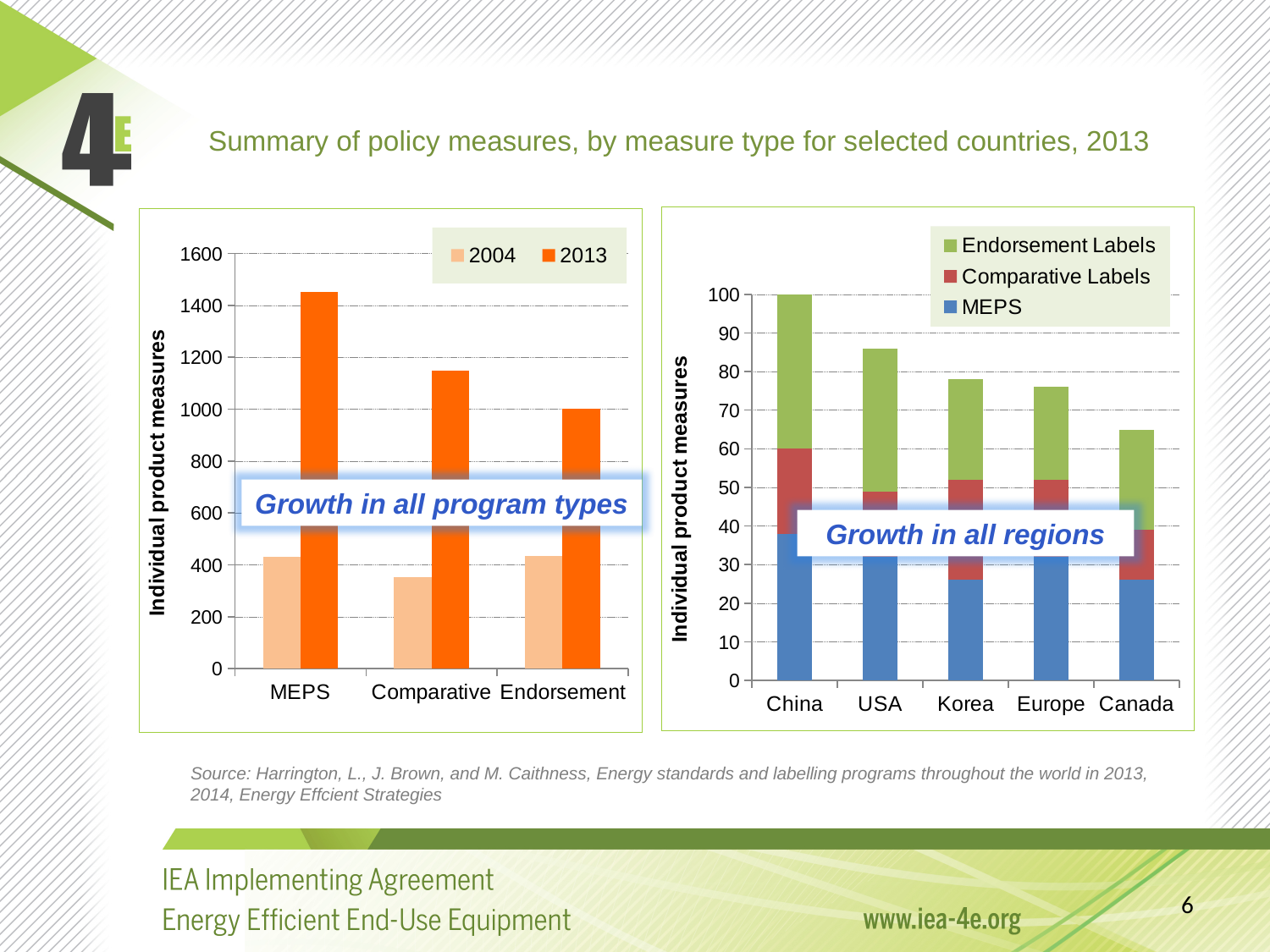
In the right chart, how many series does the legend list? 3 In the right chart, which country or region has the tallest stacked bar? China In the right chart, how many countries or regions are shown on the x axis? 5 In the left chart, how many categories are shown on the x axis? 3 In the left chart, which category has the lowest 2004 value? Comparative In the left chart, how many series does the legend list? 2 What kind of chart is the left chart on the slide? bar chart In the left chart, which category has the highest 2013 value? MEPS What kind of chart is the right chart on the slide? stacked bar chart In the right chart, is the total stacked bar for Canada greater or less than 70? less In the left chart, is the 2013 value for MEPS greater or less than 1400? greater In the left chart, is the 2004 value for Comparative greater or less than 400? less